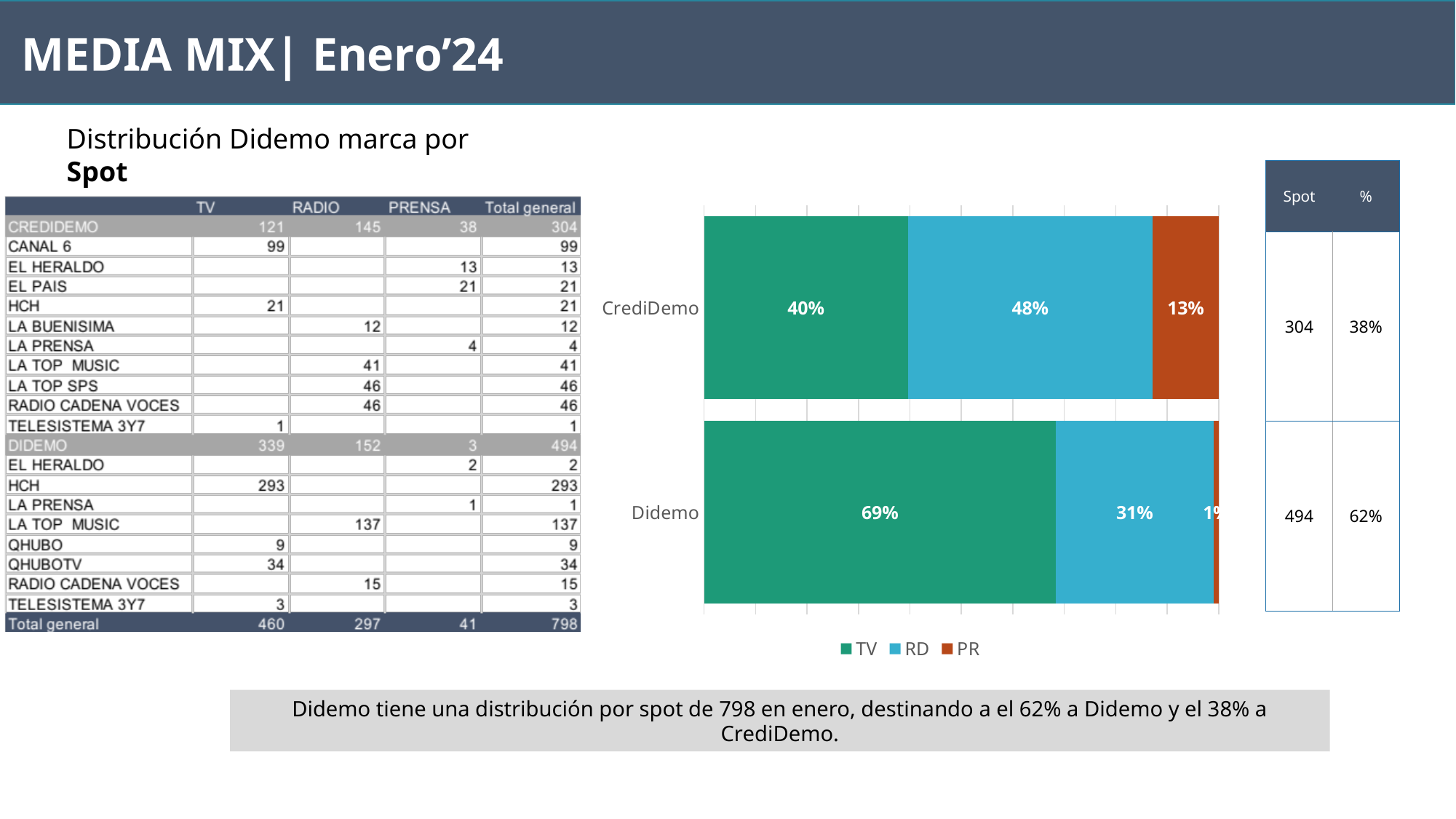
What is the TV share for CrediDemo in the chart? 40% What is the TV share for Didemo in the chart? 69% Which series has the largest share for Didemo? TV What is the RD share for CrediDemo in the chart? 48% What is the RD share for Didemo in the chart? 31% What is the difference between the TV share for Didemo and the TV share for CrediDemo? 29% Which is larger for CrediDemo, the TV share or the RD share? RD How many categories are plotted on the chart? 2 What kind of chart is shown on the slide? bar chart How many series does the chart legend list? 3 What is the PR share for CrediDemo in the chart? 13% Which series has the smallest share for CrediDemo? PR